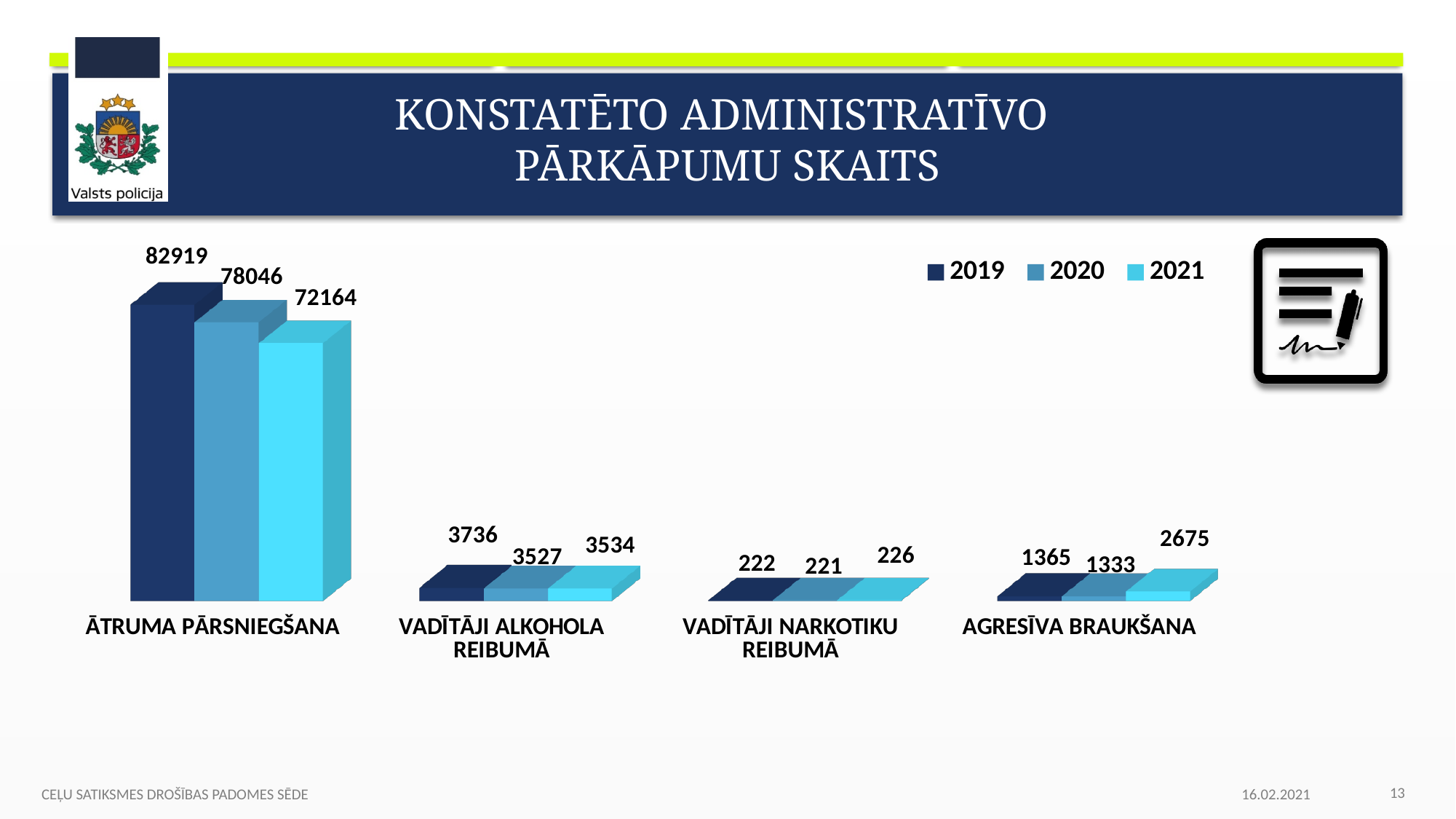
What kind of chart is shown on the slide? Bar chart What is the difference between the 2021 and 2020 values for AGRESĪVA BRAUKŠANA? 1342 What is the difference between the 2019 and 2021 values for ĀTRUMA PĀRSNIEGŠANA? 10755 Which category has the highest value in 2021? ĀTRUMA PĀRSNIEGŠANA What is the value for VADĪTĀJI NARKOTIKU REIBUMĀ in 2021? 226 How many series does the legend list? 3 What is the value for ĀTRUMA PĀRSNIEGŠANA in 2019? 82919 Which category has the lowest value in 2019? VADĪTĀJI NARKOTIKU REIBUMĀ How many categories are shown on the x axis? 4 What is the value for VADĪTĀJI ALKOHOLA REIBUMĀ in 2020? 3527 What is the value for AGRESĪVA BRAUKŠANA in 2021? 2675 Which is larger for VADĪTĀJI ALKOHOLA REIBUMĀ: the 2019 value or the 2021 value? 2019